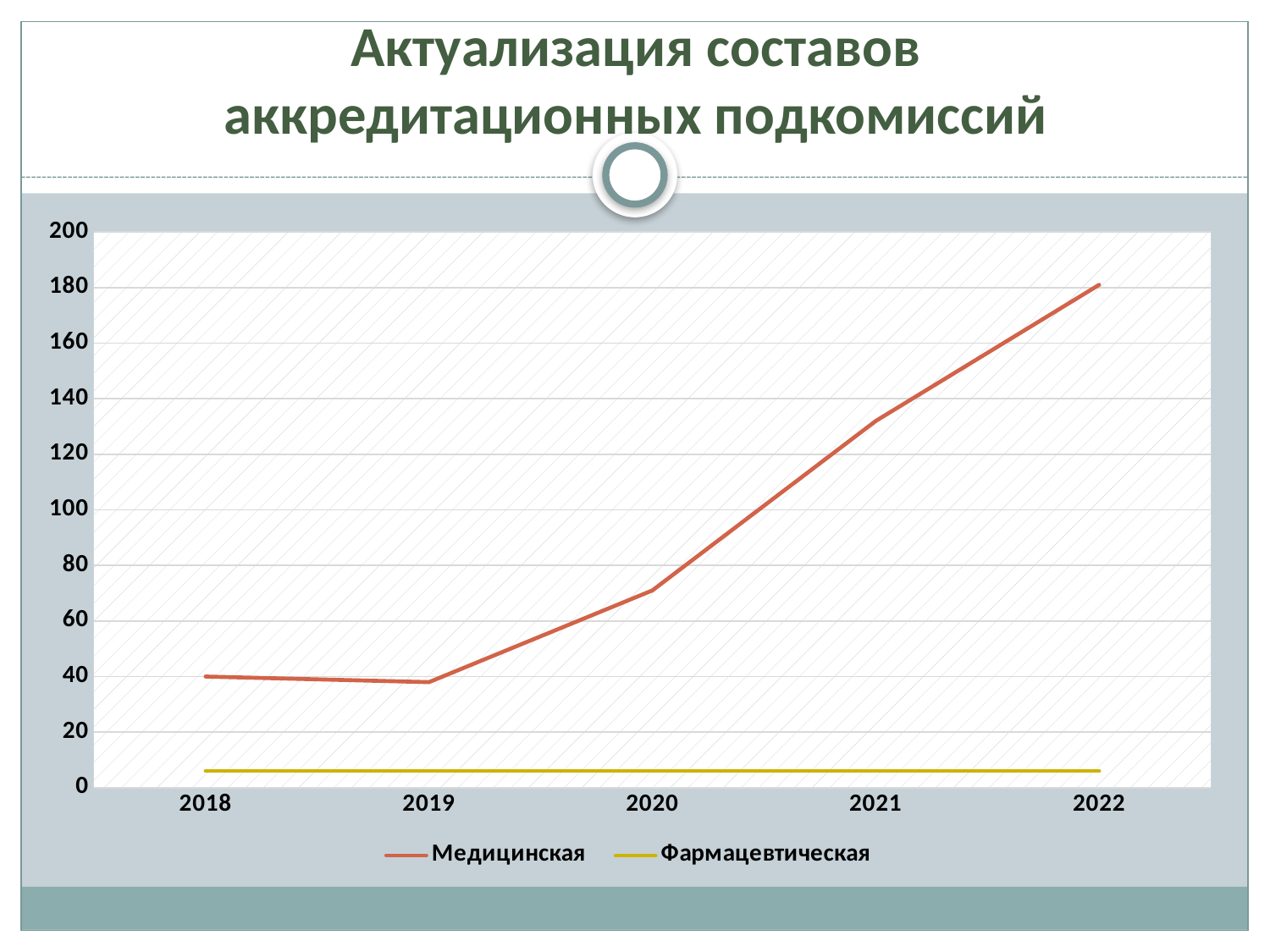
Is the value for Медицинская in 2021 greater or less than 120? greater Is the value for Фармацевтическая in 2019 greater or less than 20? less What colour is the line for the Фармацевтическая series? yellow How many years are shown on the x axis? 5 In which year does the Медицинская series reach its highest value? 2022 Is the value for Медицинская in 2022 greater or less than 160? greater Which is larger in 2021: the value for Медицинская or the value for Фармацевтическая? Медицинская How many series does the legend list? 2 Does the Медицинская series rise or fall from 2019 to 2022? rise What kind of chart is shown on the slide? line chart Which series reaches the highest value on the chart? Медицинская